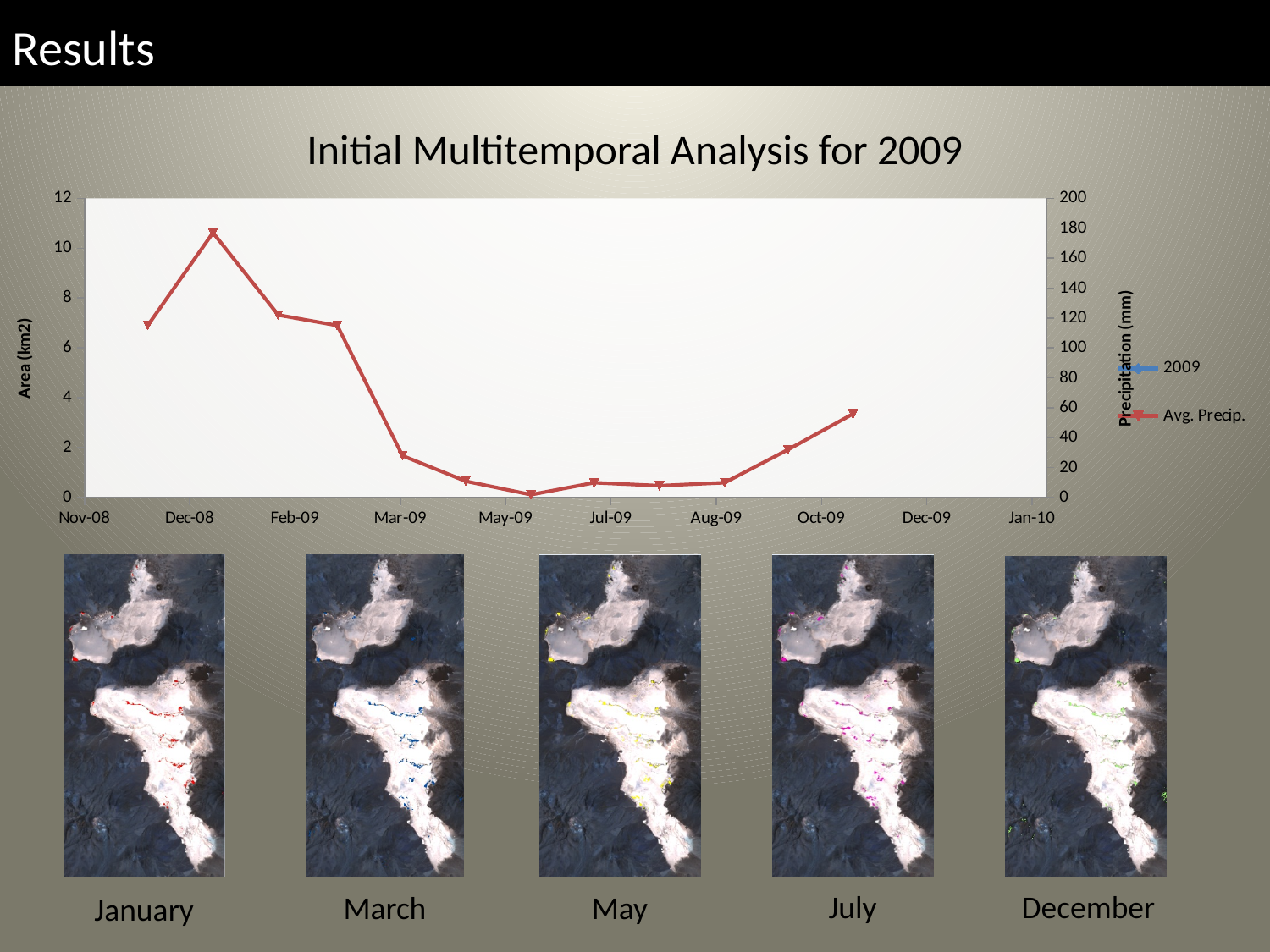
Is the highest point of the Avg. Precip. line greater or less than 160 on the right-hand axis? greater Is the lowest point of the Avg. Precip. line greater or less than 20 on the right-hand axis? less Is the last plotted point of the Avg. Precip. line (near Oct-09) greater or less than 80 on the right-hand axis? less How many data points are plotted on the Avg. Precip. line? 12 Does the Avg. Precip. line rise or fall between Aug-09 and Oct-09? rise Does the Avg. Precip. line rise or fall between its peak near Dec-08 and May-09? fall What is the title of the chart? Initial Multitemporal Analysis for 2009 What type of chart is shown on the slide? line chart Which is larger on the Avg. Precip. line: the first plotted point near Nov-08 or the last plotted point near Oct-09? the first point near Nov-08 What are the two series named in the legend? 2009 and Avg. Precip. How many series does the chart legend list? 2